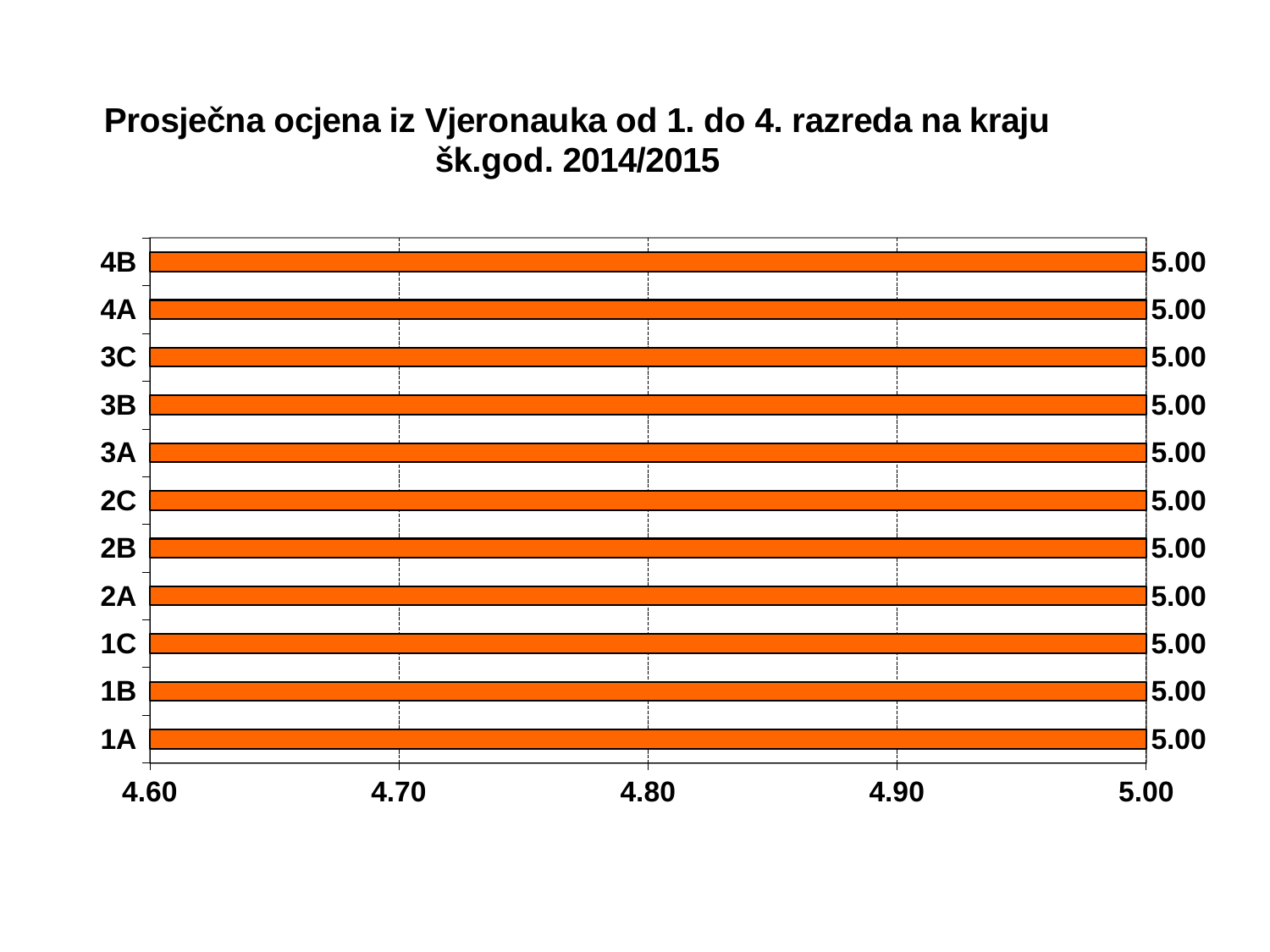
What is the title of the chart? Prosječna ocjena iz Vjeronauka od 1. do 4. razreda na kraju šk.god. 2014/2015 Is the value for 2C greater or less than 4.90? greater What is the value for 3C? 5.00 What kind of chart is shown on the slide? bar chart Do the values differ between the classes, or are they all the same? all the same How many classes (categories) are shown in the chart? 11 What colour are the bars in the chart? orange What is the difference between the values for 4A and 1C? 0.00 What is the value for 1A? 5.00 What is the value for 4B? 5.00 What is the value for 2B? 5.00 Is the value for 1B greater or less than 4.80? greater